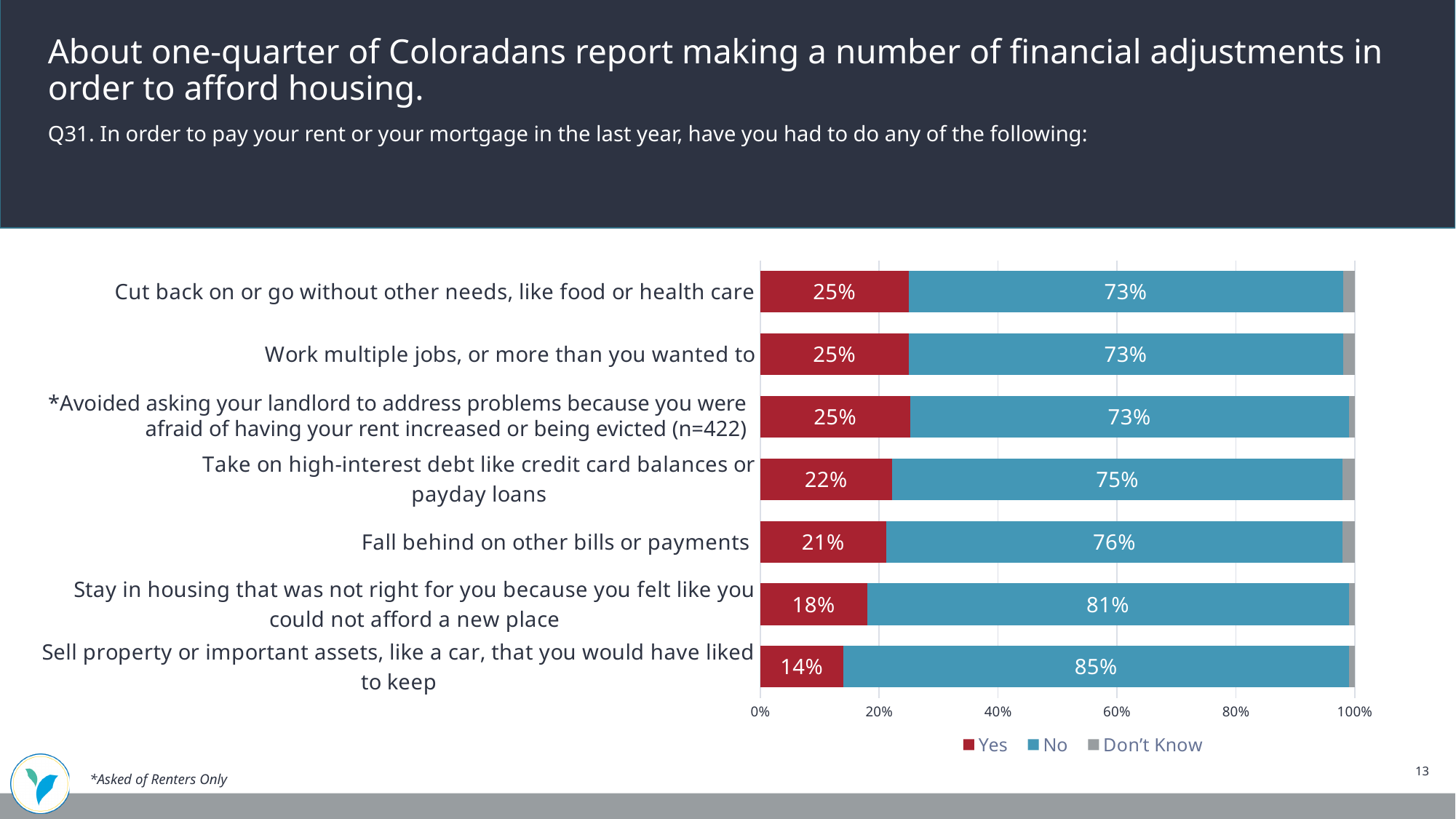
Which category has the lowest Yes percentage? Sell property or important assets, like a car, that you would have liked to keep What kind of chart is shown on the slide? Stacked bar chart What percentage answered No to "Sell property or important assets, like a car, that you would have liked to keep"? 85% What is the Yes value for "Fall behind on other bills or payments"? 21% What is the difference in percentage points between the Yes value for "Work multiple jobs, or more than you wanted to" and the Yes value for "Sell property or important assets, like a car, that you would have liked to keep"? 11 How many series does the legend list? 3 What is the No value for "Stay in housing that was not right for you because you felt like you could not afford a new place"? 81% How many categories (survey items) are shown in the chart? 7 What percentage answered Yes to "Cut back on or go without other needs, like food or health care"? 25% Which category has the highest No percentage? Sell property or important assets, like a car, that you would have liked to keep Is the Yes value for "Sell property or important assets, like a car, that you would have liked to keep" greater or less than 20%? less Which has a larger Yes value: "Fall behind on other bills or payments" or "Stay in housing that was not right for you because you felt like you could not afford a new place"? Fall behind on other bills or payments